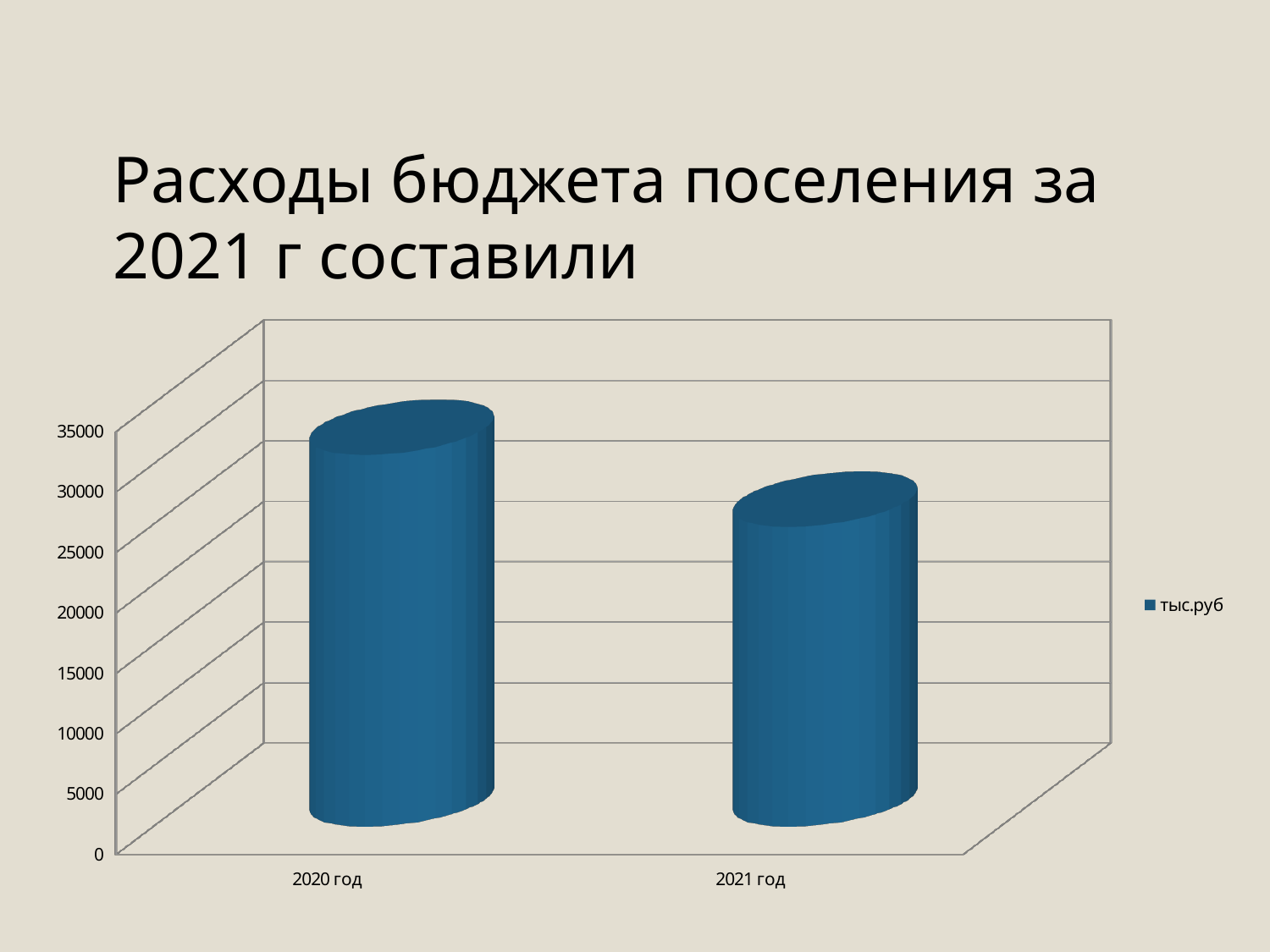
What is the legend entry of the chart? тыс.руб Is the value for 2020 год greater or less than 30000? greater Do the values rise or fall from 2020 год to 2021 год? fall How many categories are plotted on the x axis? 2 What kind of chart is shown on the slide? bar chart What is the title of the slide? Расходы бюджета поселения за 2021 г составили Which year has the lowest value? 2021 год How many series does the legend list? 1 Is the value for 2021 год greater or less than 35000? less Which year has the highest value? 2020 год Which is larger, the value for 2020 год or for 2021 год? 2020 год